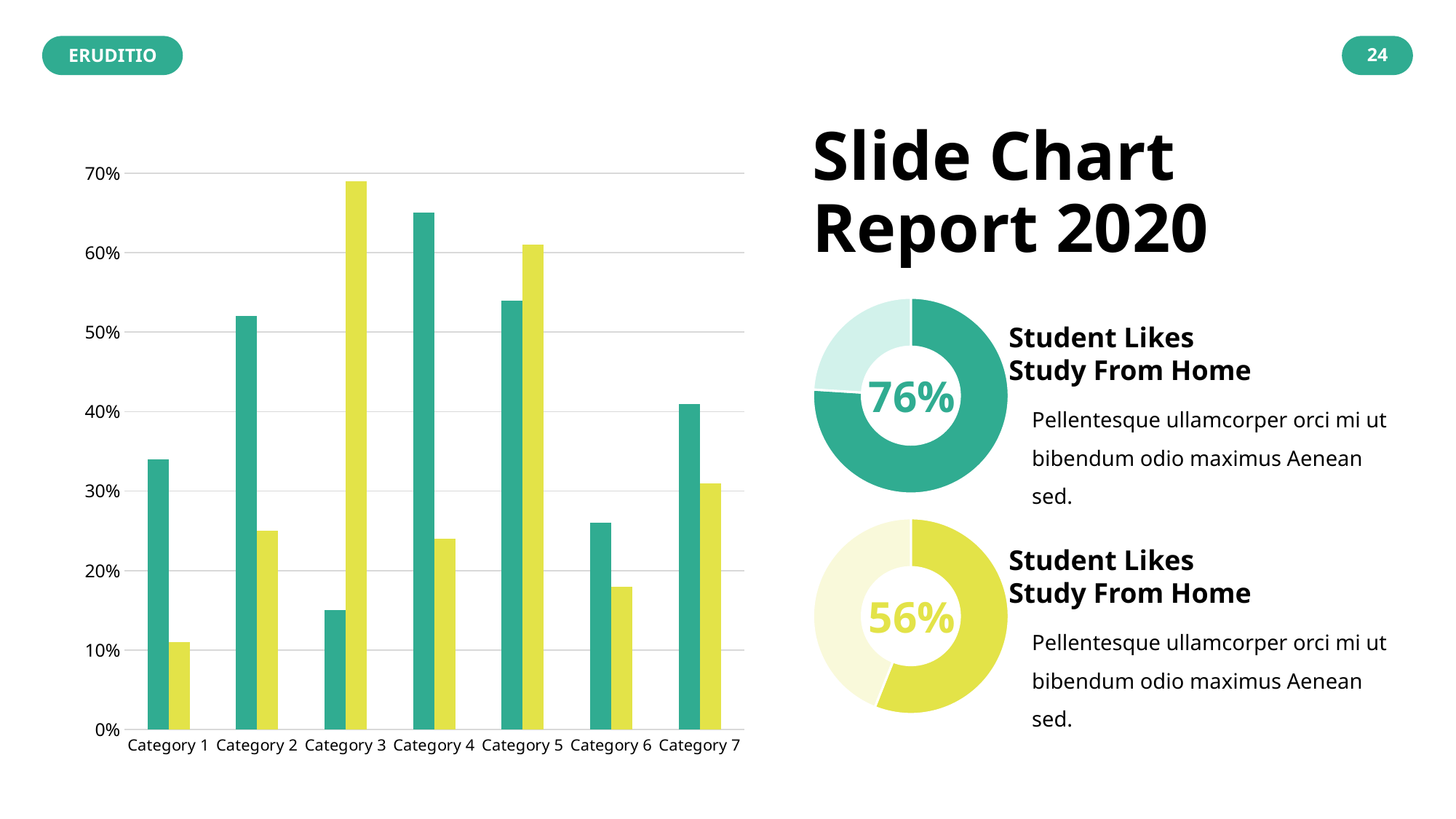
In the bar chart, which category has the tallest yellow bar? Category 3 In the bar chart, which category has the shortest green bar? Category 3 In the bar chart, for Category 2, which bar is taller, the green one or the yellow one? green How many categories are shown on the x axis of the bar chart? 7 In the bar chart, is the yellow bar for Category 6 greater or less than 20%? less What percentage is shown in the centre of the upper (green) donut chart? 76% What percentage is shown in the centre of the lower (yellow) donut chart? 56% In the bar chart, which category has the tallest green bar? Category 4 In the bar chart, is the green bar for Category 1 greater or less than 30%? greater In the bar chart, for Category 3, which bar is taller, the green one or the yellow one? yellow In the bar chart, which category has the shortest yellow bar? Category 1 What kind of chart is the chart on the left side of the slide? bar chart